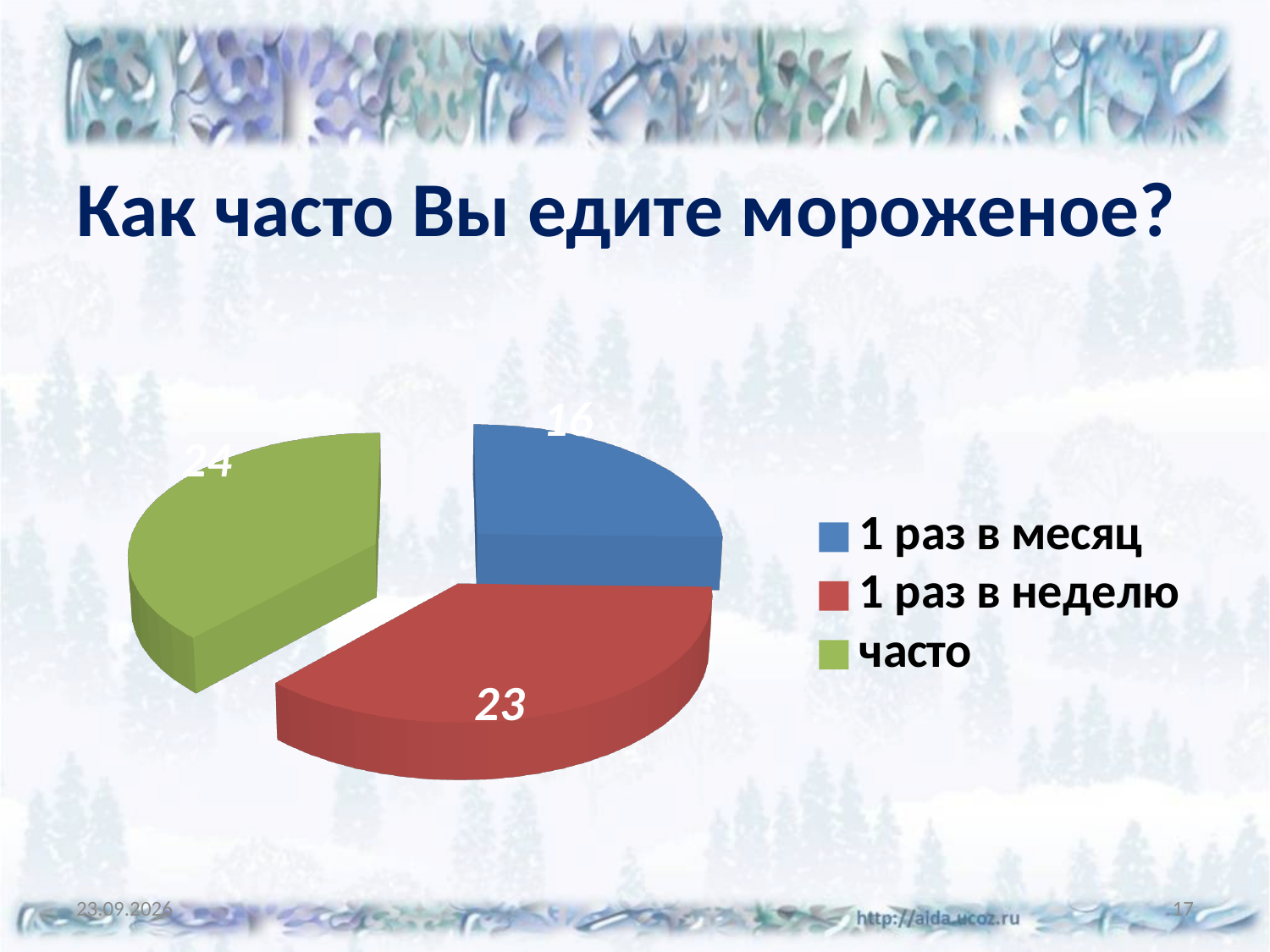
Which category has the lowest value? 1 раз в месяц What is the difference between the values for "часто" and "1 раз в месяц"? 8 Which category has the highest value? часто What is the value for "часто"? 24 What is the title of the slide? Как часто Вы едите мороженое? What colour is the slice for "часто"? Green Which is larger, the value for "1 раз в неделю" or the value for "1 раз в месяц"? 1 раз в неделю How many slices does the pie chart have? 3 What is the value for "1 раз в месяц"? 16 What type of chart is shown on the slide? Pie chart What is the value for "1 раз в неделю"? 23 What is the difference between the values for "1 раз в неделю" and "1 раз в месяц"? 7